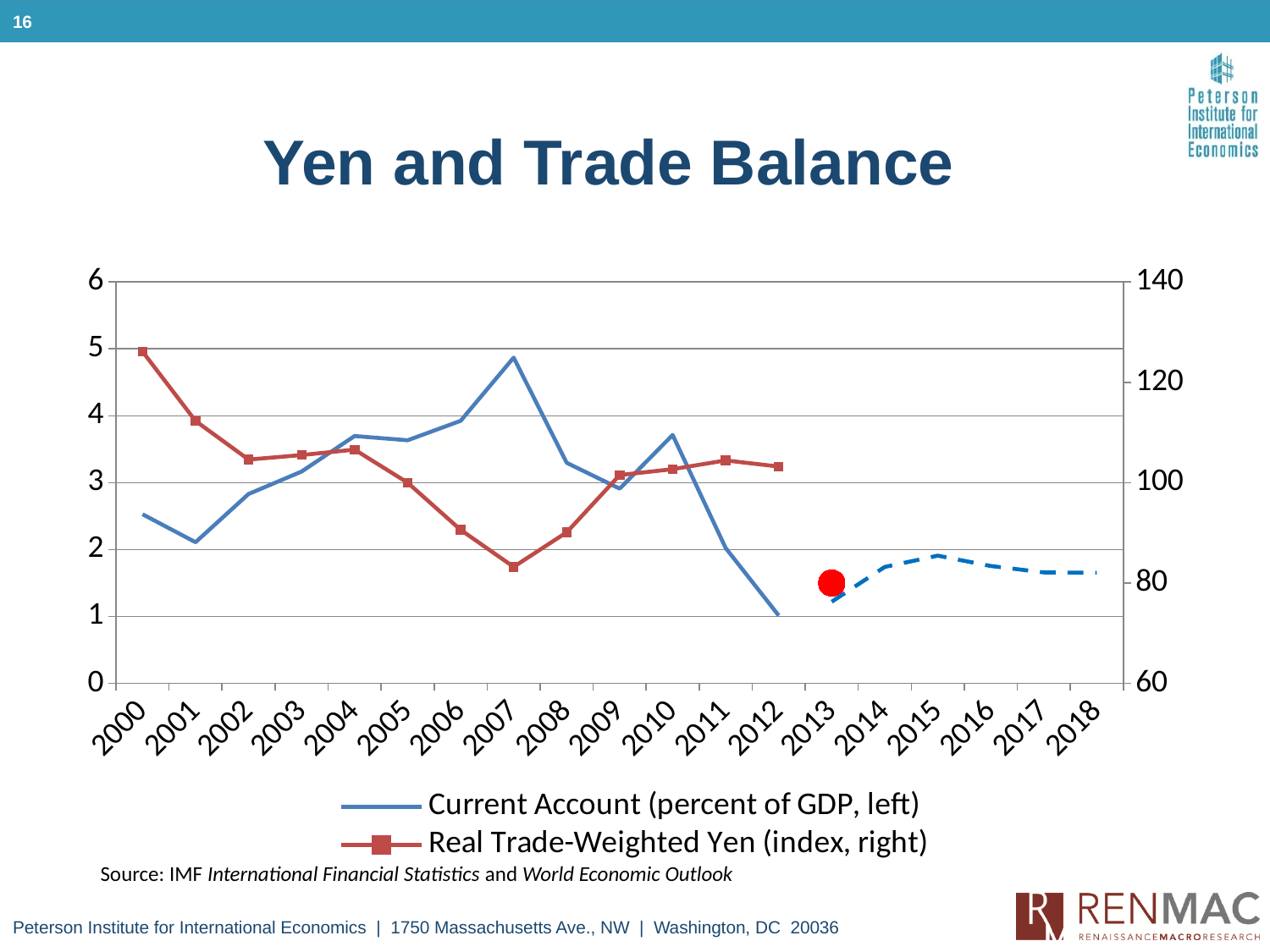
How many series does the legend list? 2 How many years are labelled along the x axis? 19 In which year does the Real Trade-Weighted Yen series reach its highest value? 2000 In which year does the Current Account (percent of GDP) series reach its highest value? 2007 Which axis does the Real Trade-Weighted Yen series use, left or right? right Does the Current Account series rise or fall from 2010 to 2012? fall Is the Current Account value for 2007 greater or less than 4? greater Is the Real Trade-Weighted Yen value for 2007 greater or less than 100? less Which is larger, the Current Account value for 2007 or for 2001? 2007 What is the title of the chart? Yen and Trade Balance What kind of chart is shown on the slide? line chart In which year does the Real Trade-Weighted Yen series reach its lowest value? 2007